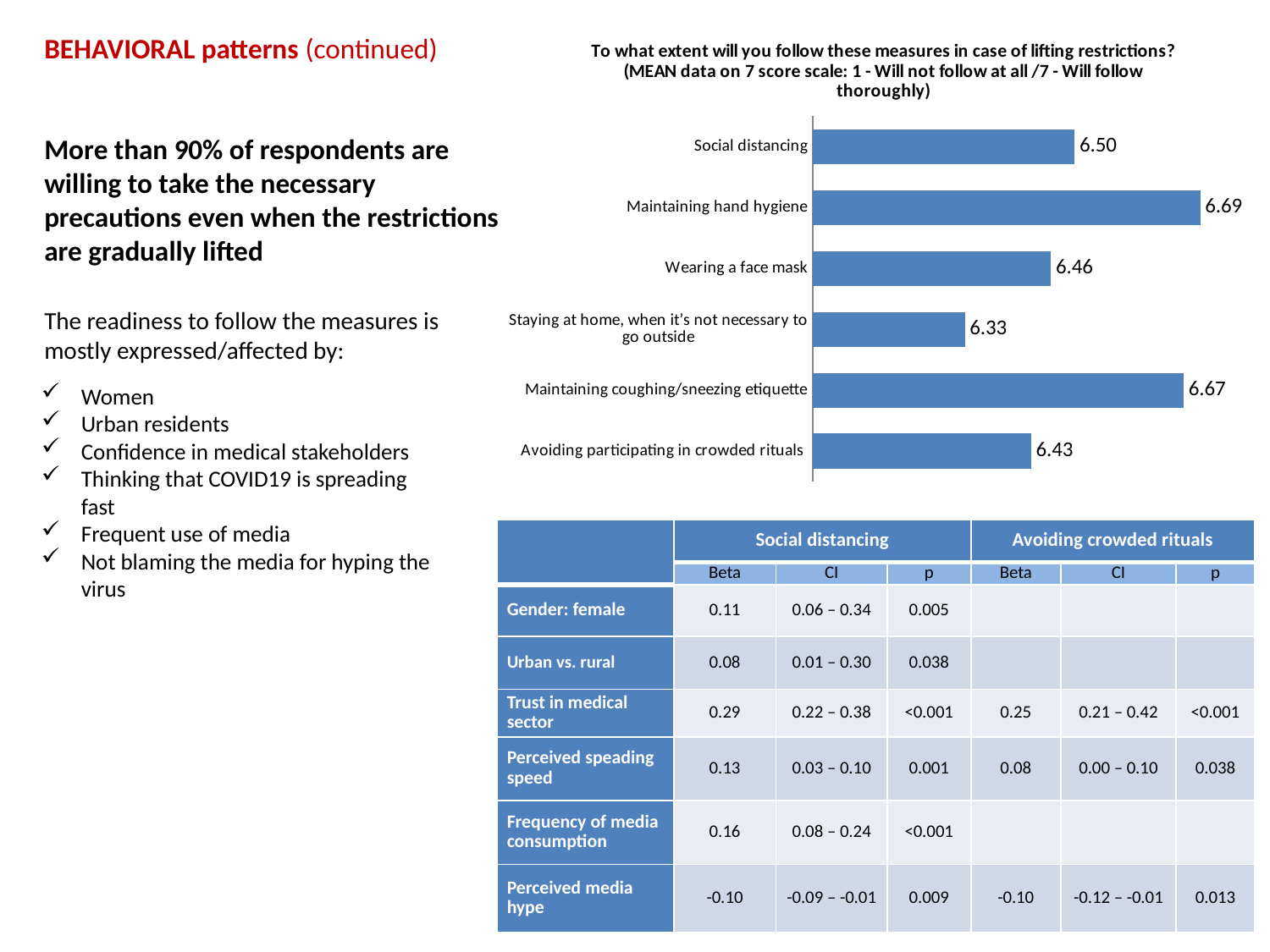
Which measure has the highest mean score? Maintaining hand hygiene How many measures are shown in the chart? 6 What is the difference between the mean scores for Social distancing and Wearing a face mask? 0.04 What type of chart is used to show the mean scores? Bar chart What is the difference between the mean scores for Maintaining hand hygiene and Staying at home, when it's not necessary to go outside? 0.36 What scale is used for the mean data in the chart, according to its title? 7 score scale What is the mean score for Staying at home, when it's not necessary to go outside? 6.33 Which has a higher mean score, Maintaining coughing/sneezing etiquette or Wearing a face mask? Maintaining coughing/sneezing etiquette Which has a higher mean score, Social distancing or Avoiding participating in crowded rituals? Social distancing What is the mean score for Maintaining hand hygiene? 6.69 What is the mean score for Avoiding participating in crowded rituals? 6.43 Which measure has the lowest mean score? Staying at home, when it's not necessary to go outside